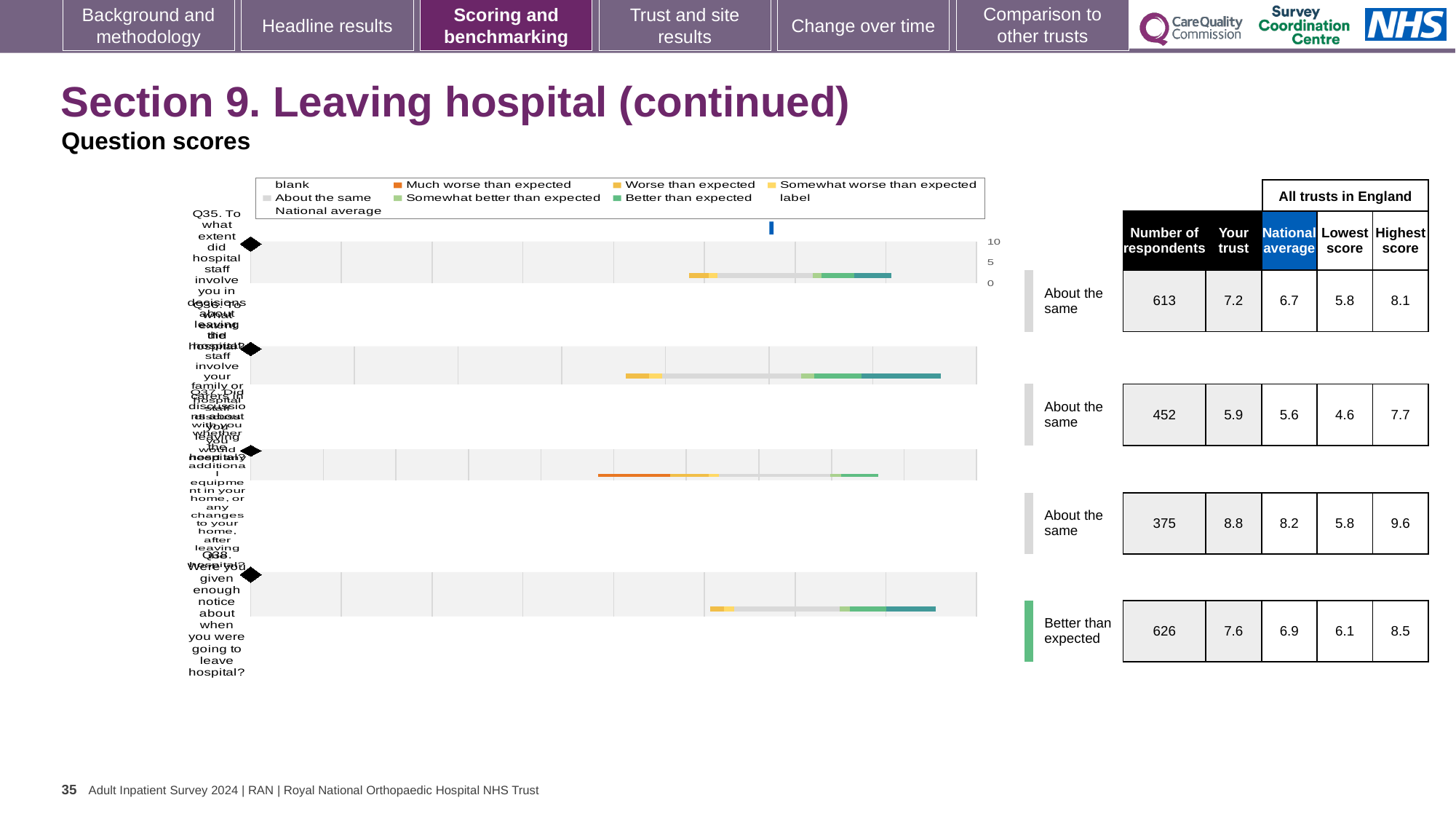
By how much does the 'Your trust' score for Q35 (top row) exceed its national average? 0.5 What is the 'Highest score' value for the third row of the chart? 9.6 What kind of chart is used to show the question scores on this slide? bar chart Which has the higher 'Your trust' score, Q35 (top row) or Q38 (bottom row)? Q38 By how much does the 'Your trust' score for Q38 (bottom row) exceed its national average? 0.7 How many respondents are listed for Q38 (the bottom row of the chart)? 626 How many question rows (bars) are plotted in the chart? 4 What is the highest 'Your trust' score shown in the table next to the chart? 8.8 What is the lowest value in the 'Lowest score' column of the table? 4.6 What is the national average for Q35 (the top row of the chart)? 6.7 What is the 'Your trust' score for Q35 (the top row of the chart)? 7.2 What benchmark category is shown for Q38 (the bottom row of the chart)? Better than expected